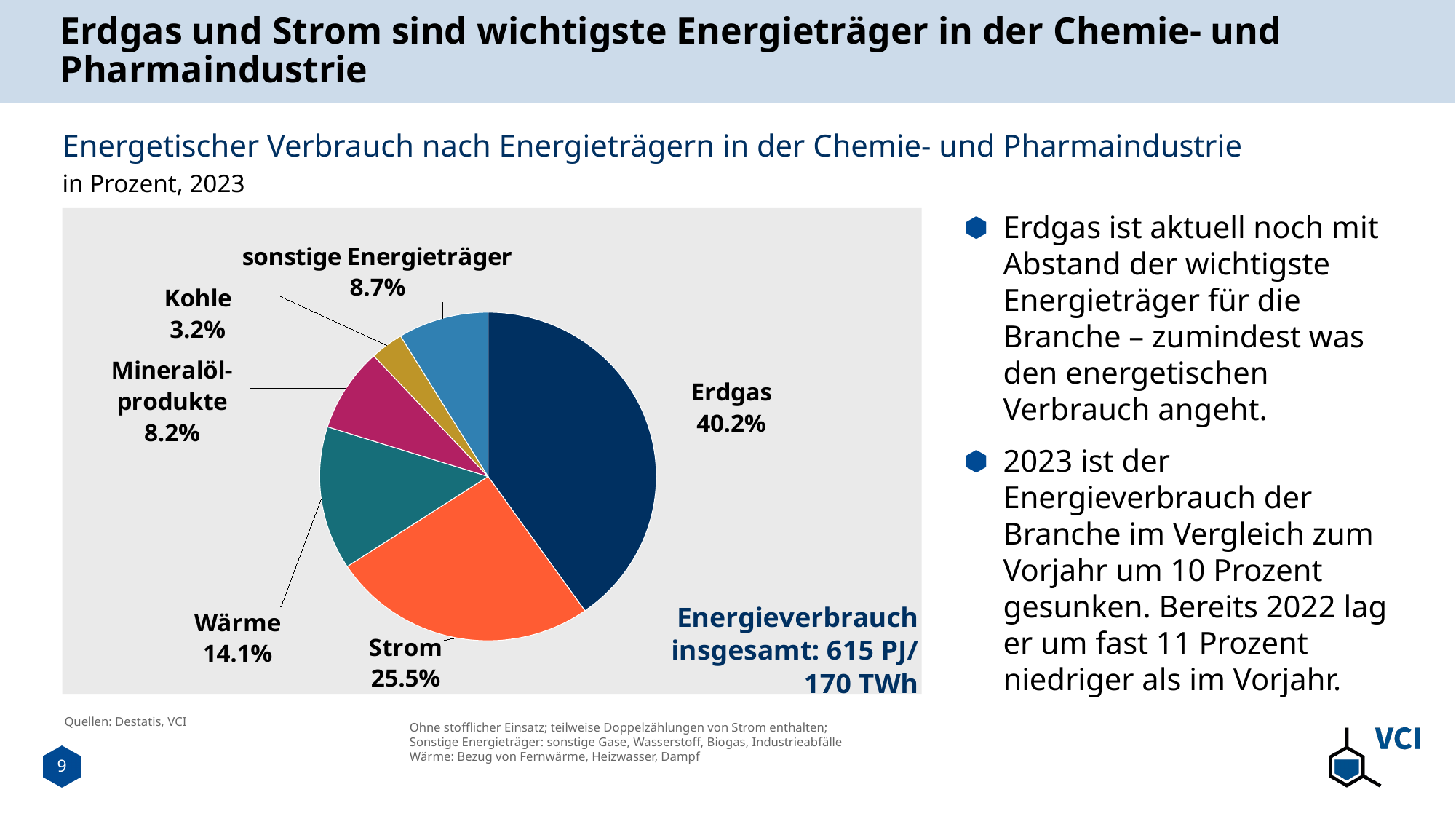
What is the value for Kohle in the pie chart? 3.2% What type of chart is shown on the slide? Pie chart Which energy source has the largest slice of the pie chart? Erdgas What percentage is shown for Wärme? 14.1% Which energy source has the smallest slice of the pie chart? Kohle Which is larger, the share for Mineralölprodukte or the share for sonstige Energieträger? sonstige Energieträger What share of energy consumption does Erdgas account for in the pie chart? 40.2% How many categories are shown in the pie chart? 6 What is the difference in percentage points between Erdgas and Strom? 14.7 What is the value shown for Strom in the pie chart? 25.5% What total energy consumption is stated next to the pie chart? 615 PJ/170 TWh What year does the chart refer to? 2023